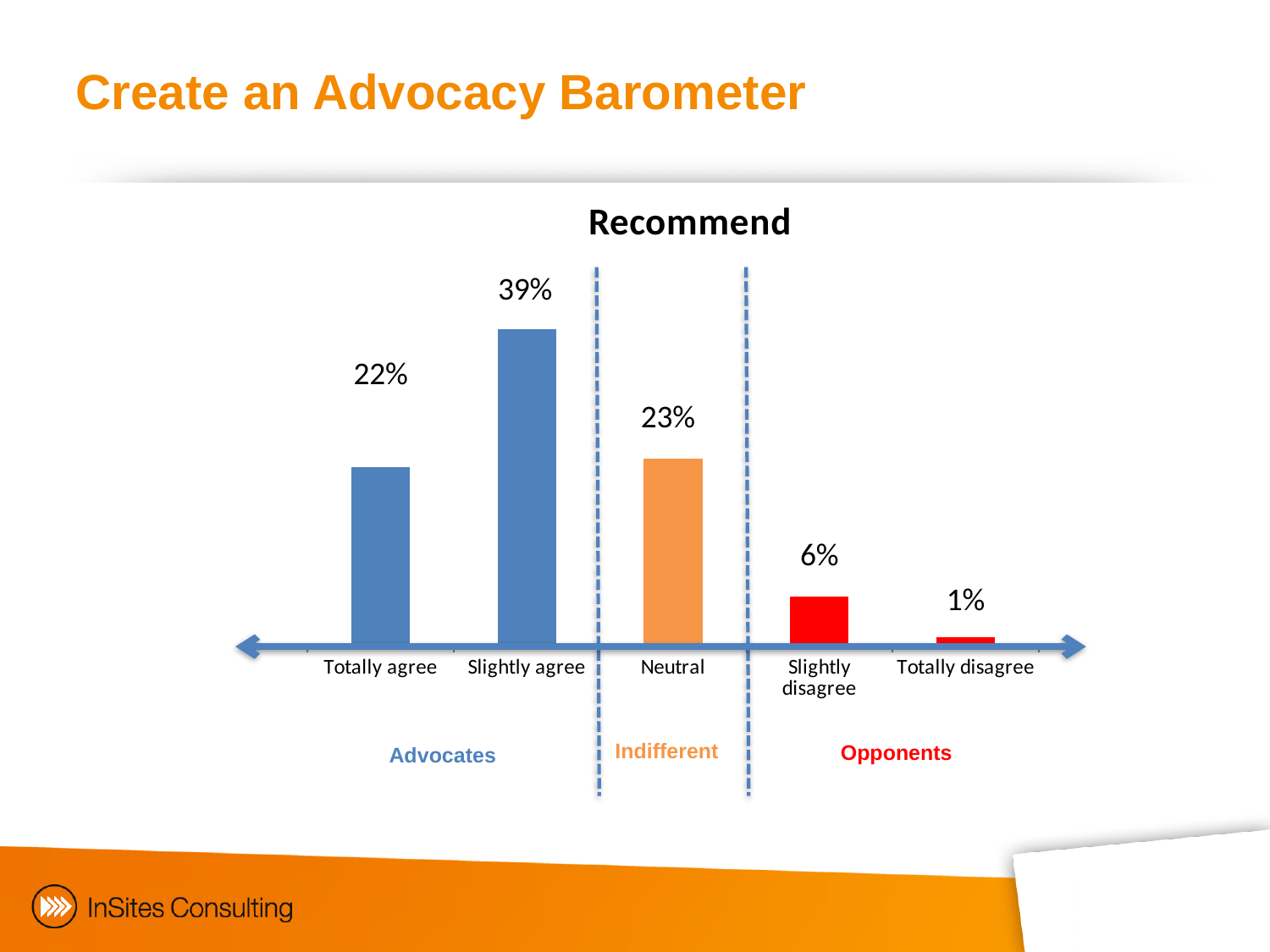
What is the title of the chart? Recommend Which category has the highest value? Slightly agree What is the difference between Neutral and Slightly disagree? 17% What is the value for Neutral? 23% What is the difference between Slightly agree and Totally agree? 17% How many categories are shown on the x axis? 5 What kind of chart is this? Bar chart What colour are the bars in the Opponents group? Red Which category has the lowest value? Totally disagree Which is larger, Totally agree or Neutral? Neutral What is the value for Slightly agree? 39% What is the value for Totally disagree? 1%